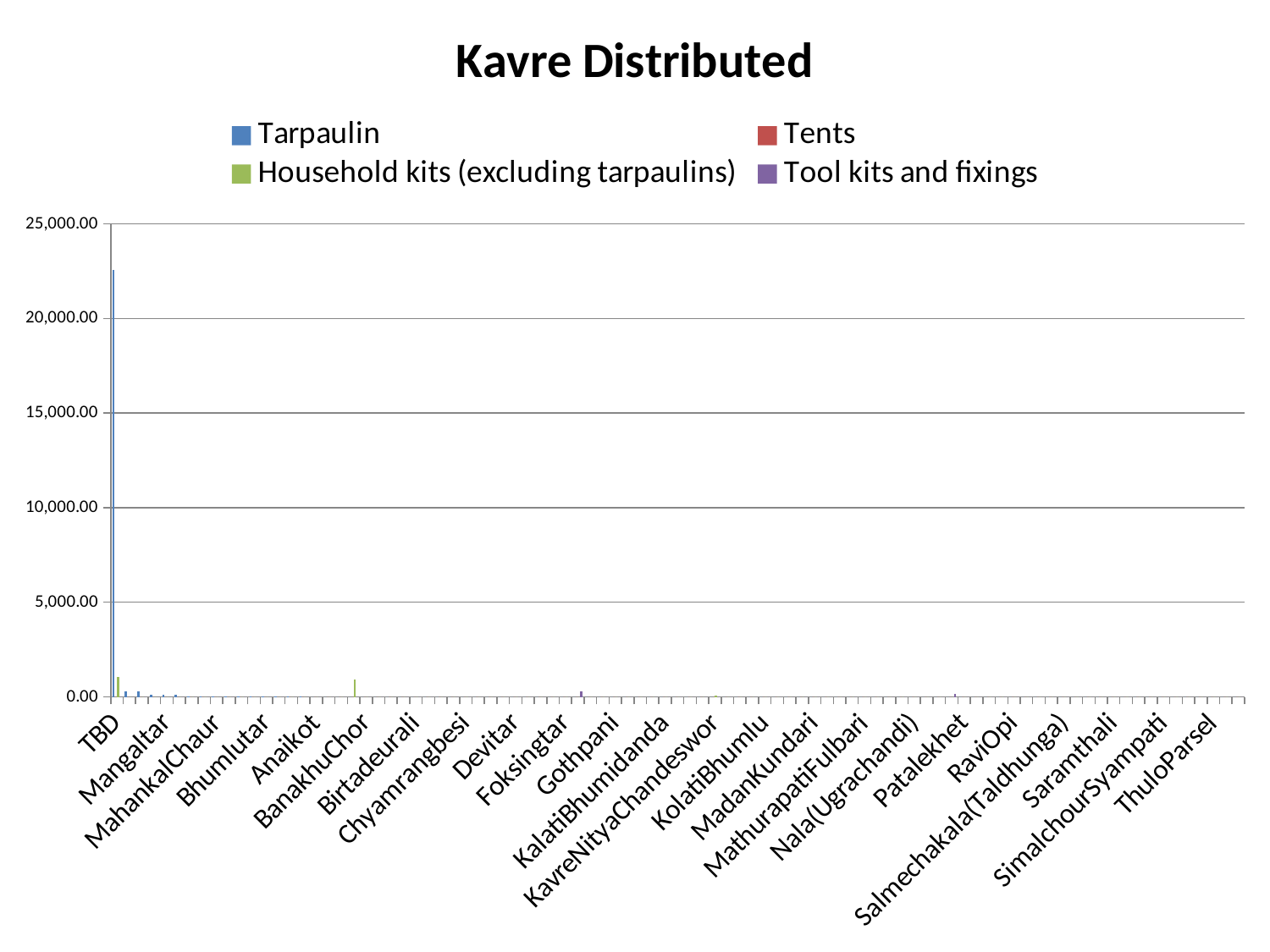
Is the Tarpaulin value for TBD greater or less than 20,000.00? greater What is the highest value shown on the vertical axis? 25,000.00 Is the Household kits (excluding tarpaulins) value for TBD greater or less than 5,000.00? less Which is larger for TBD: the Tarpaulin value or the Household kits (excluding tarpaulins) value? Tarpaulin Is the Tarpaulin value for TBD greater or less than 25,000.00? less Which category has the highest Tarpaulin value? TBD How many series does the legend list? 4 What is the title of the chart? Kavre Distributed Which series is shown in green in the legend? Household kits (excluding tarpaulins) What kind of chart is shown on the slide? bar chart